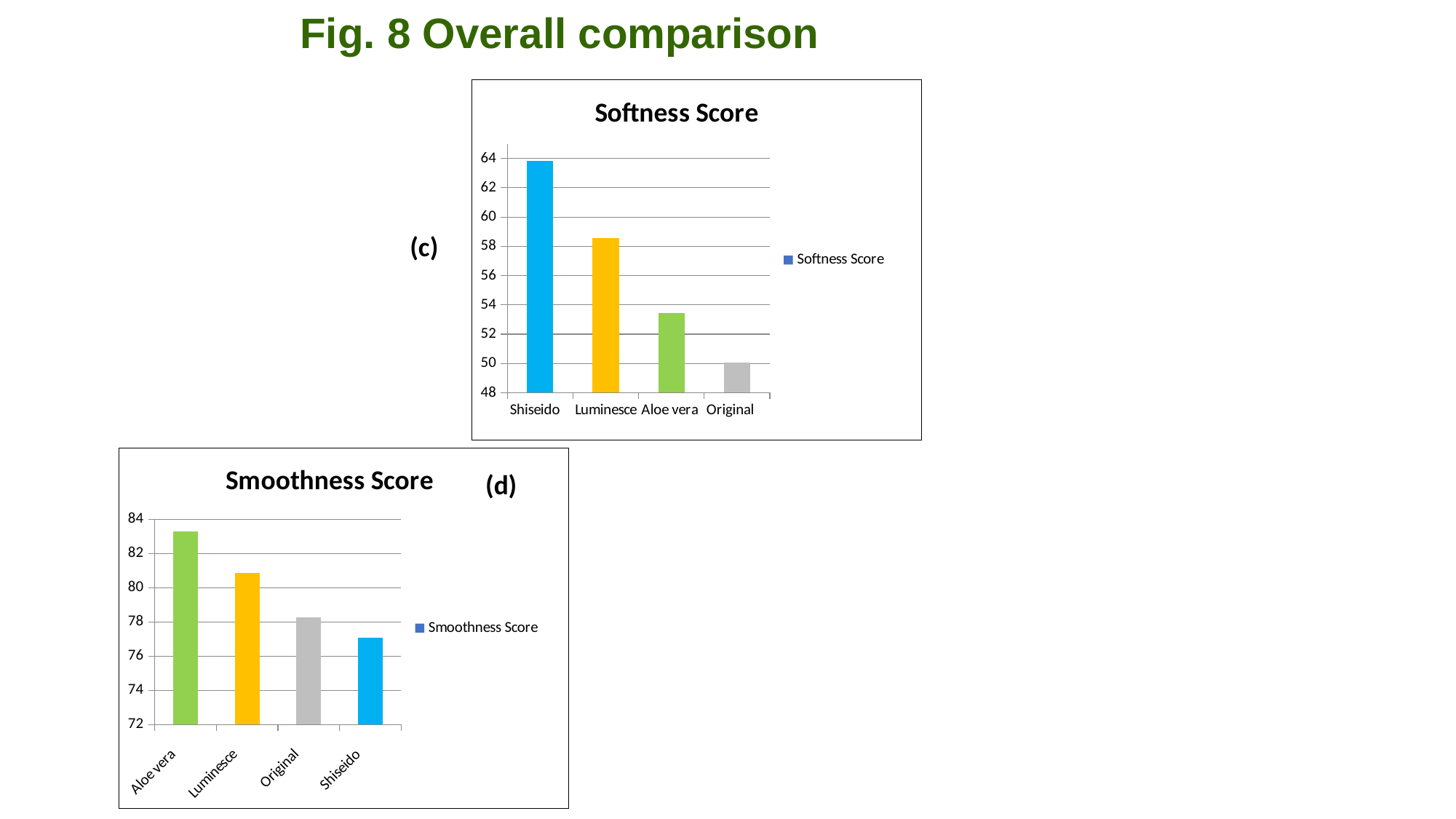
In the Softness Score chart, which product has the highest softness score? Shiseido In the Softness Score chart, is the value for Aloe vera greater or less than 54? less In the Smoothness Score chart, is the value for Shiseido greater or less than 78? less In the Softness Score chart, which product has the lowest softness score? Original In the Smoothness Score chart, which product has the lowest smoothness score? Shiseido In the Smoothness Score chart, is the value for Luminesce greater or less than 80? greater What kind of chart is the Smoothness Score chart? Bar chart In the Softness Score chart, which is larger, the value for Luminesce or the value for Aloe vera? Luminesce How many products are shown in the Softness Score chart? 4 In the Smoothness Score chart, which product has the highest smoothness score? Aloe vera How many series does the legend of the Smoothness Score chart list? 1